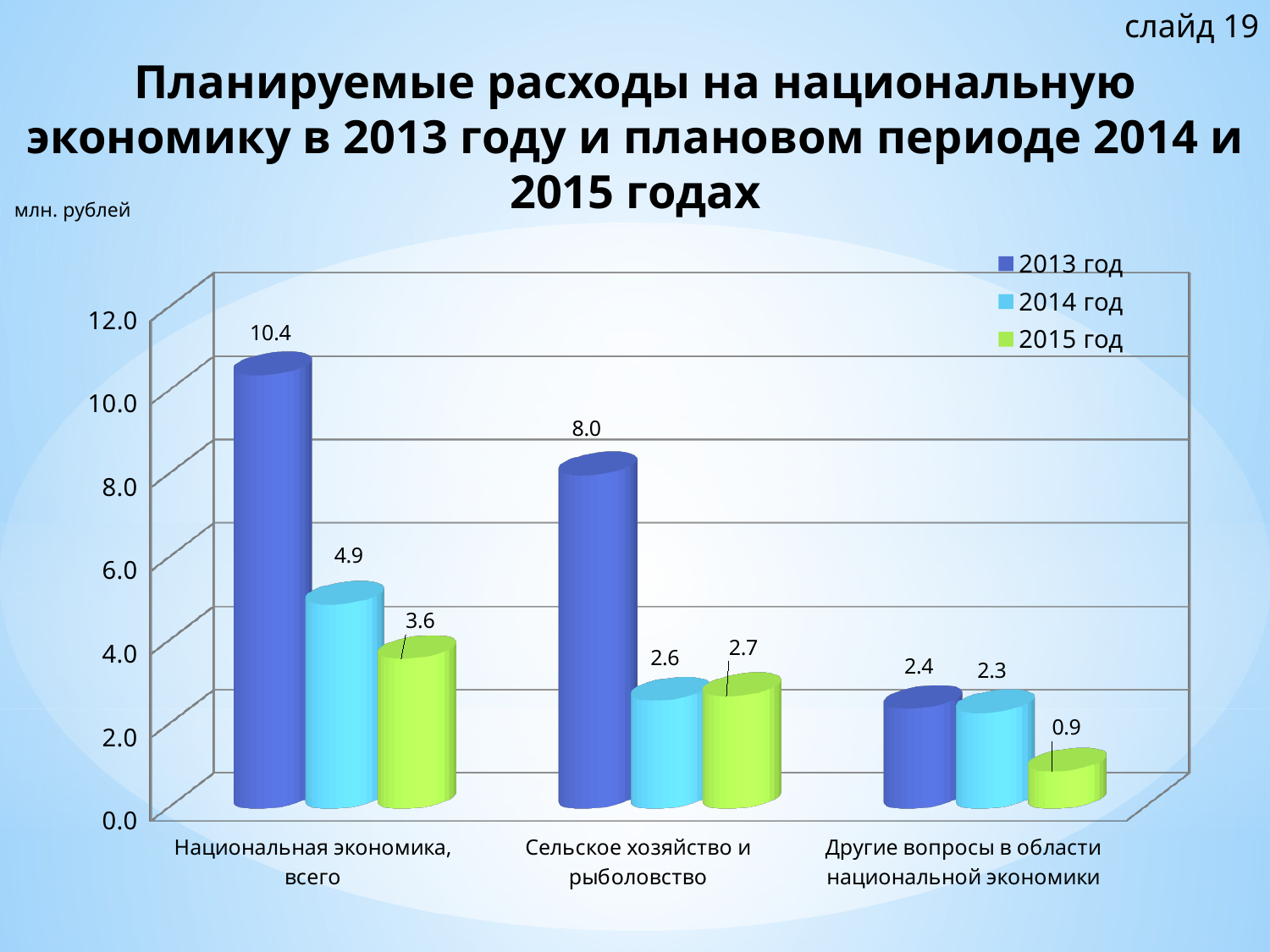
Do the values for Национальная экономика, всего rise or fall from 2013 год to 2015 год? fall What is the difference between the 2013 год and 2015 год values for Национальная экономика, всего? 6.8 What unit is indicated for the values on the chart? млн. рублей What is the value for 2015 год in the category Сельское хозяйство и рыболовство? 2.7 What is the value for 2014 год in the category Другие вопросы в области национальной экономики? 2.3 Which category has the lowest value for 2015 год? Другие вопросы в области национальной экономики How many categories are shown on the x axis? 3 Which is larger for Сельское хозяйство и рыболовство: the 2014 год value or the 2015 год value? 2015 год What is the value for 2013 год in the category Национальная экономика, всего? 10.4 How many series does the legend list? 3 What kind of chart is shown on the slide? bar chart Which category has the highest value for 2013 год? Национальная экономика, всего